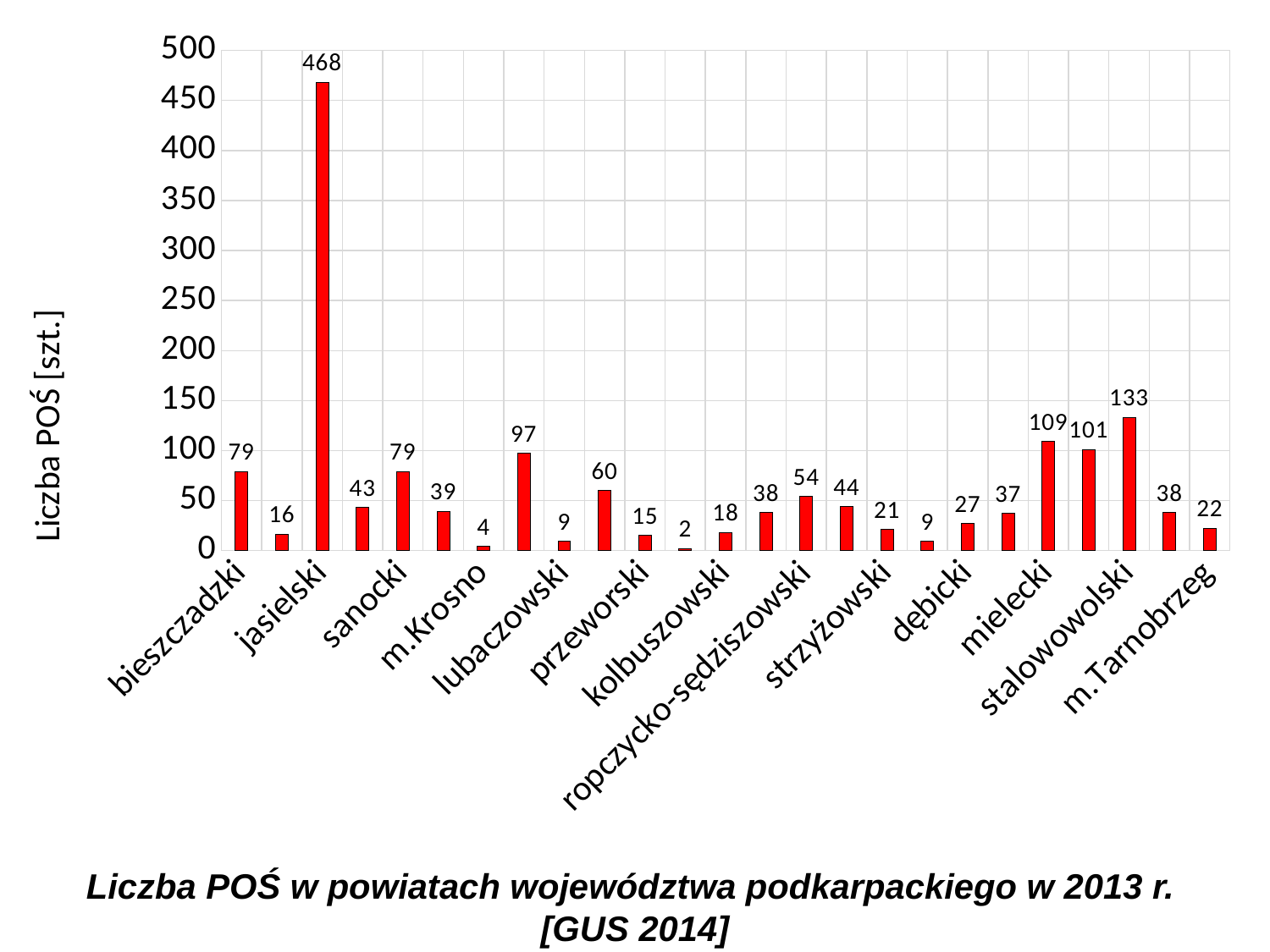
Which is larger, the value for mielecki or the value for bieszczadzki? mielecki What is the value for m.Krosno? 4 What is the smallest value labelled on any bar in the chart? 2 What type of chart is shown on the slide? bar chart What is the value for stalowowolski? 133 What is the value for jasielski? 468 What is the y-axis title of the chart? Liczba POŚ [szt.] What is the difference between the values for jasielski and stalowowolski? 335 What is the caption/title given below the chart? Liczba POŚ w powiatach województwa podkarpackiego w 2013 r. [GUS 2014] Which category has the highest value? jasielski What is the value for mielecki? 109 How many bars are plotted in the chart? 25